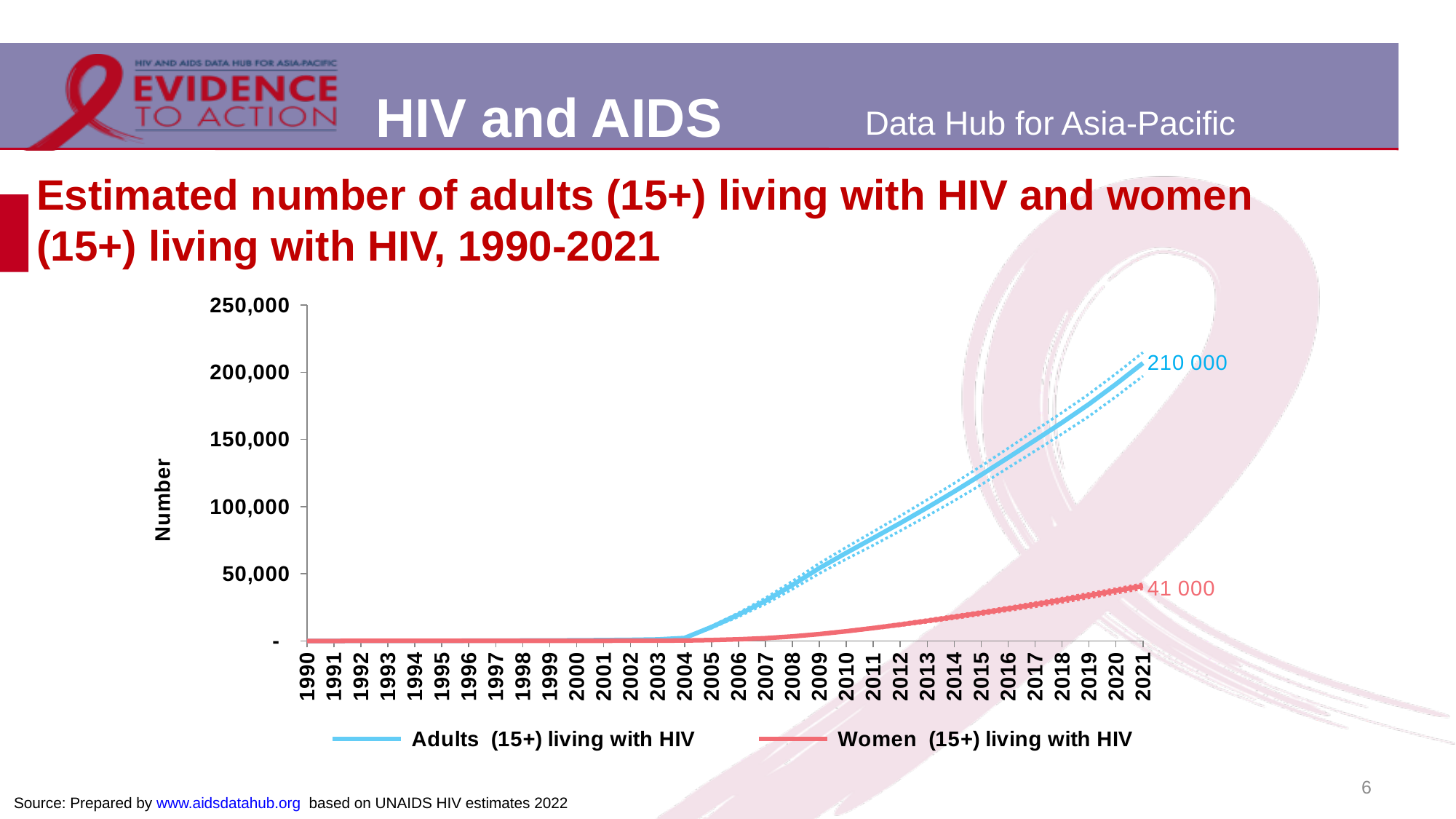
What kind of chart is shown on the slide? Line chart What is the title of the y axis of the chart? Number Is the value for Adults (15+) living with HIV in 2021 greater or less than 200,000? greater How many series does the chart legend list? 2 What is the estimated number of women (15+) living with HIV in 2021? 41 000 What is the difference between the number of adults (15+) living with HIV and the number of women (15+) living with HIV in 2021? 169 000 Does the number of adults (15+) living with HIV rise or fall from 2004 to 2021? Rise Is the value for Women (15+) living with HIV in 2021 greater or less than 50,000? less Is the value for Adults (15+) living with HIV in 2015 greater or less than 100,000? greater How many years are shown on the x axis of the chart? 32 In 2021, which series has the larger value: Adults (15+) living with HIV or Women (15+) living with HIV? Adults (15+) living with HIV What is the estimated number of adults (15+) living with HIV in 2021? 210 000